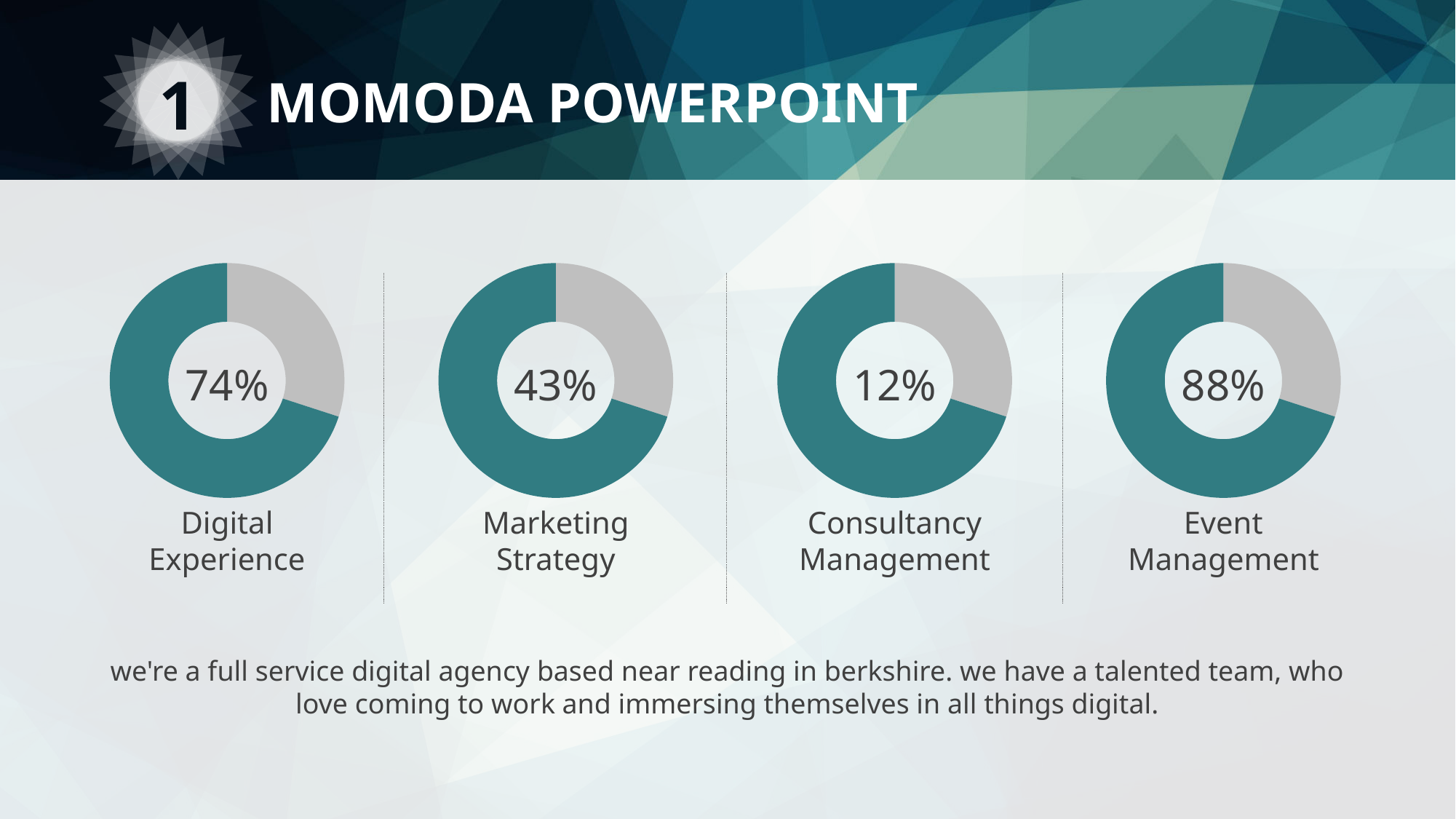
What percentage is shown in the Event Management chart? 88% How many donut charts are shown on the slide? 4 Which of the four charts shows the highest percentage? Event Management What is the difference between the Digital Experience percentage and the Marketing Strategy percentage? 31% Which is larger, the Marketing Strategy percentage or the Consultancy Management percentage? Marketing Strategy What colour is the filled portion of each donut chart? Teal What percentage is shown in the Marketing Strategy chart? 43% What percentage is shown in the Digital Experience chart? 74% What percentage is shown in the Consultancy Management chart? 12% What is the difference between the Event Management percentage and the Digital Experience percentage? 14% What kind of chart is used for the Digital Experience figure? Donut chart Which of the four charts shows the lowest percentage? Consultancy Management